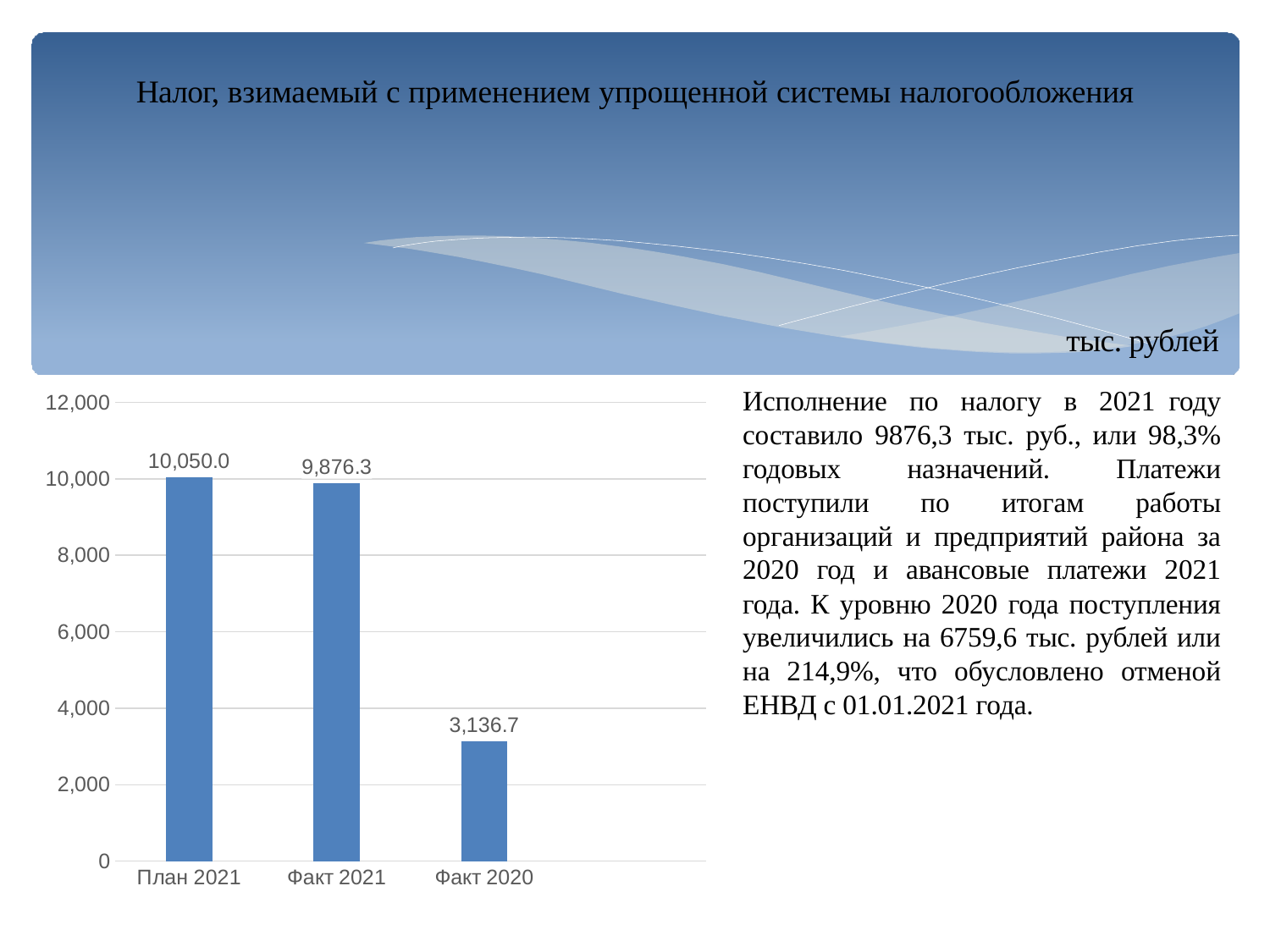
What is the difference between Факт 2021 and Факт 2020? 6,739.6 What is the value for Факт 2021? 9,876.3 What is the value for Факт 2020? 3,136.7 Which category has the highest value? План 2021 Which category has the lowest value? Факт 2020 Is the value for Факт 2020 greater or less than 4,000? less What is the value for План 2021? 10,050.0 How many categories are shown on the x axis? 3 What is the difference between План 2021 and Факт 2021? 173.7 What unit is stated for the chart values? тыс. рублей Which is larger, Факт 2021 or Факт 2020? Факт 2021 What kind of chart is shown on the slide? bar chart